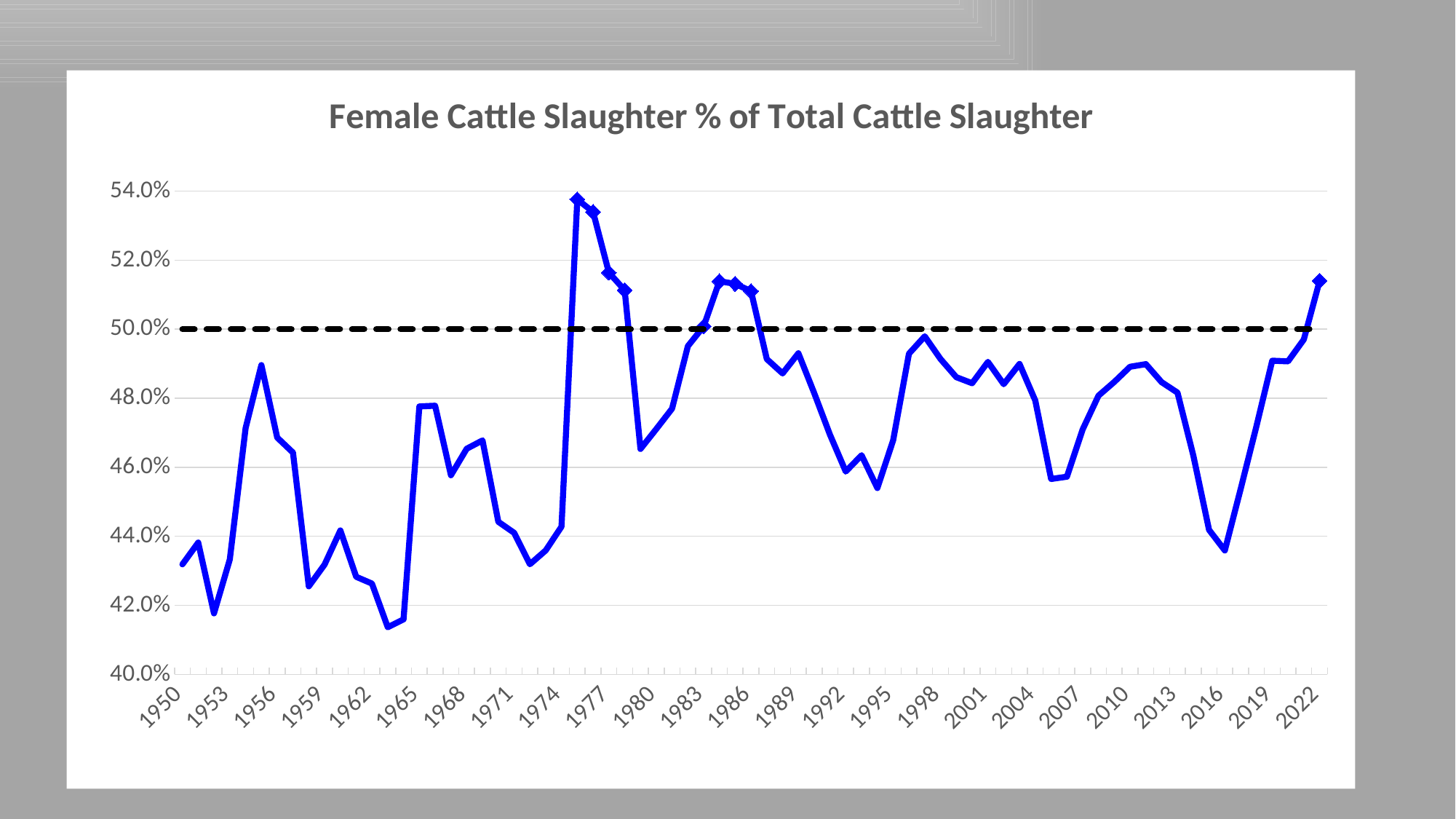
At what value on the y axis is the horizontal dashed reference line drawn? 50.0% Is the value for 1950 greater or less than 44.0%? less Which year has the larger value, 1950 or 1956? 1956 Which year has the larger value, 1975 or 2022? 1975 What kind of chart is shown on the slide? Line chart Is the value for 1980 greater or less than 48.0%? less Does the female cattle slaughter percentage rise or fall between 2016 and 2022? Rise Is the value for 1977 greater or less than 50.0%? greater What is the title of the chart? Female Cattle Slaughter % of Total Cattle Slaughter In which year does the female cattle slaughter percentage reach its highest point? 1975